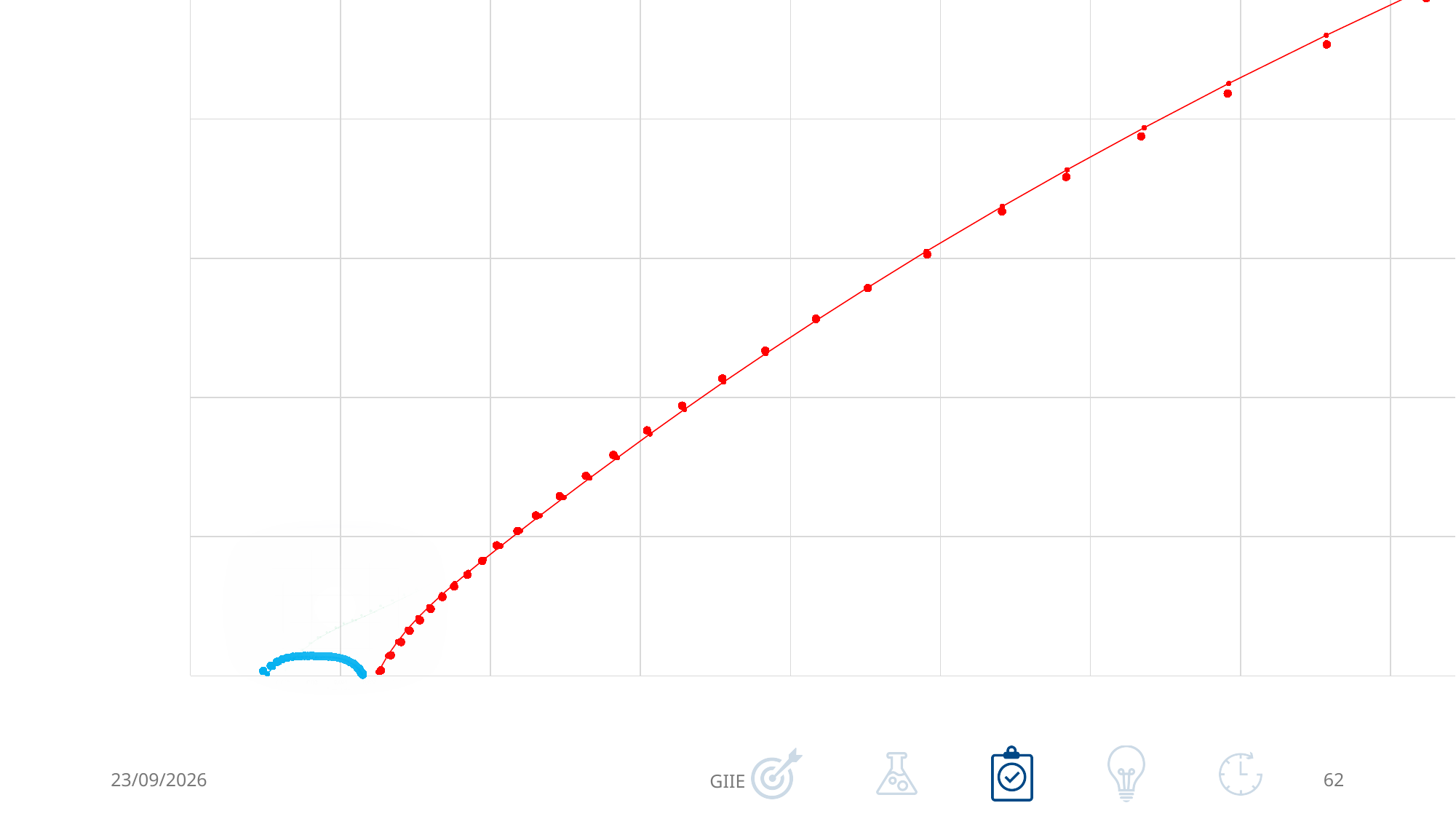
What colour is the series that rises steadily across the whole chart? red Do the red points rise or fall as you move from left to right along the x axis? rise What colour are the points clustered near the bottom left of the chart? blue What kind of chart is shown on the slide? scatter chart